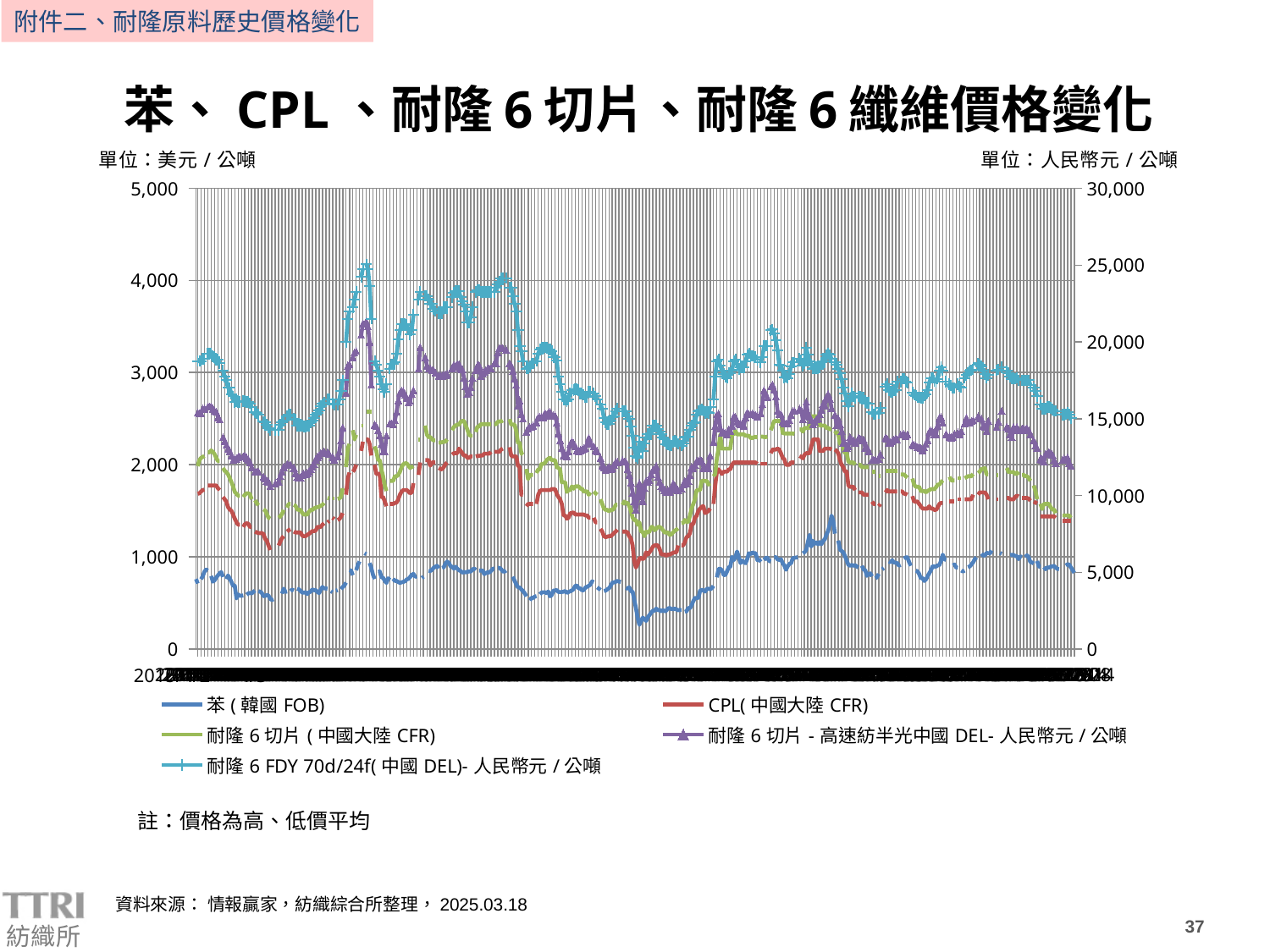
What kind of chart is shown on the slide? line chart Is the peak value of the 耐隆 6 FDY 70d/24f( 中國 DEL) line greater or less than 20,000 on the right axis? greater Is the peak value of the CPL( 中國大陸 CFR) line greater or less than 3,000 on the left axis? less What is the maximum value shown on the left y-axis? 5,000 Is the peak value of the 苯 ( 韓國 FOB) line greater or less than 2,000 on the left axis? less Which series is plotted highest on the chart across the whole period? 耐隆 6 FDY 70d/24f( 中國 DEL)- 人民幣元 / 公噸 How many series does the legend list? 5 What unit is given for the right y-axis? 人民幣元 / 公噸 Which series is plotted lowest on the chart across the whole period? 苯 ( 韓國 FOB) Which series is plotted higher throughout the chart, 苯 ( 韓國 FOB) or CPL( 中國大陸 CFR)? CPL( 中國大陸 CFR)